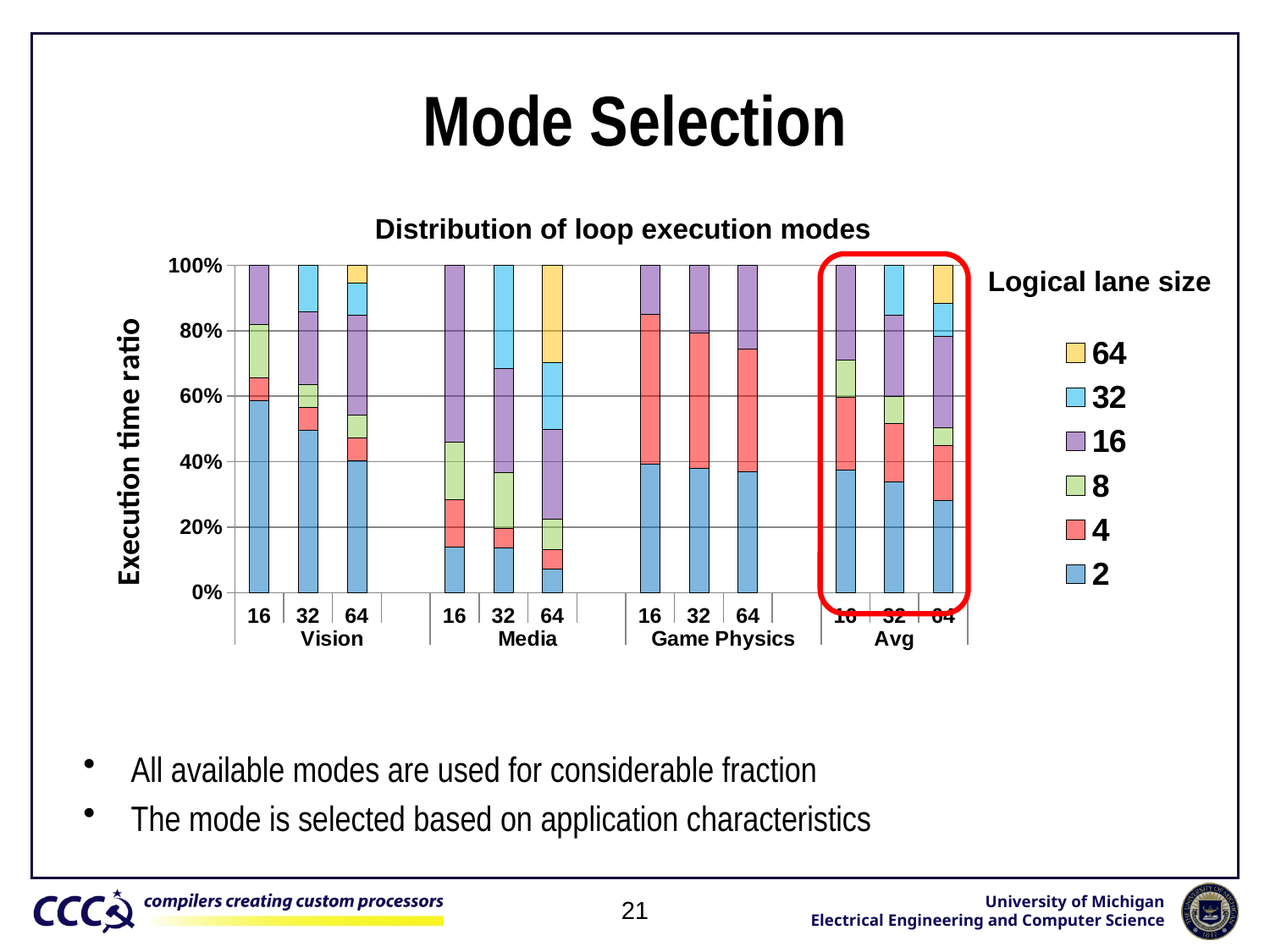
How many bars are plotted in the chart? 12 Which bar has the largest lane size 2 (blue) segment? Vision 16 Is the lane size 2 (blue) segment of the Avg 64 bar greater or less than 40%? less What is the title of the chart? Distribution of loop execution modes What kind of chart is shown on the slide? Stacked bar chart Is the lane size 2 (blue) segment of the Vision 16 bar greater or less than 40%? greater Which bar has the larger lane size 2 (blue) segment: Vision 16 or Media 16? Vision 16 What is the label of the vertical axis? Execution time ratio Which bar has the larger lane size 64 (yellow) segment: Media 64 or Vision 64? Media 64 How many series does the legend list? 6 Within the Vision group, does the lane size 2 (blue) segment rise or fall from 16 to 64? fall Is the lane size 2 (blue) segment of the Media 16 bar greater or less than 20%? less